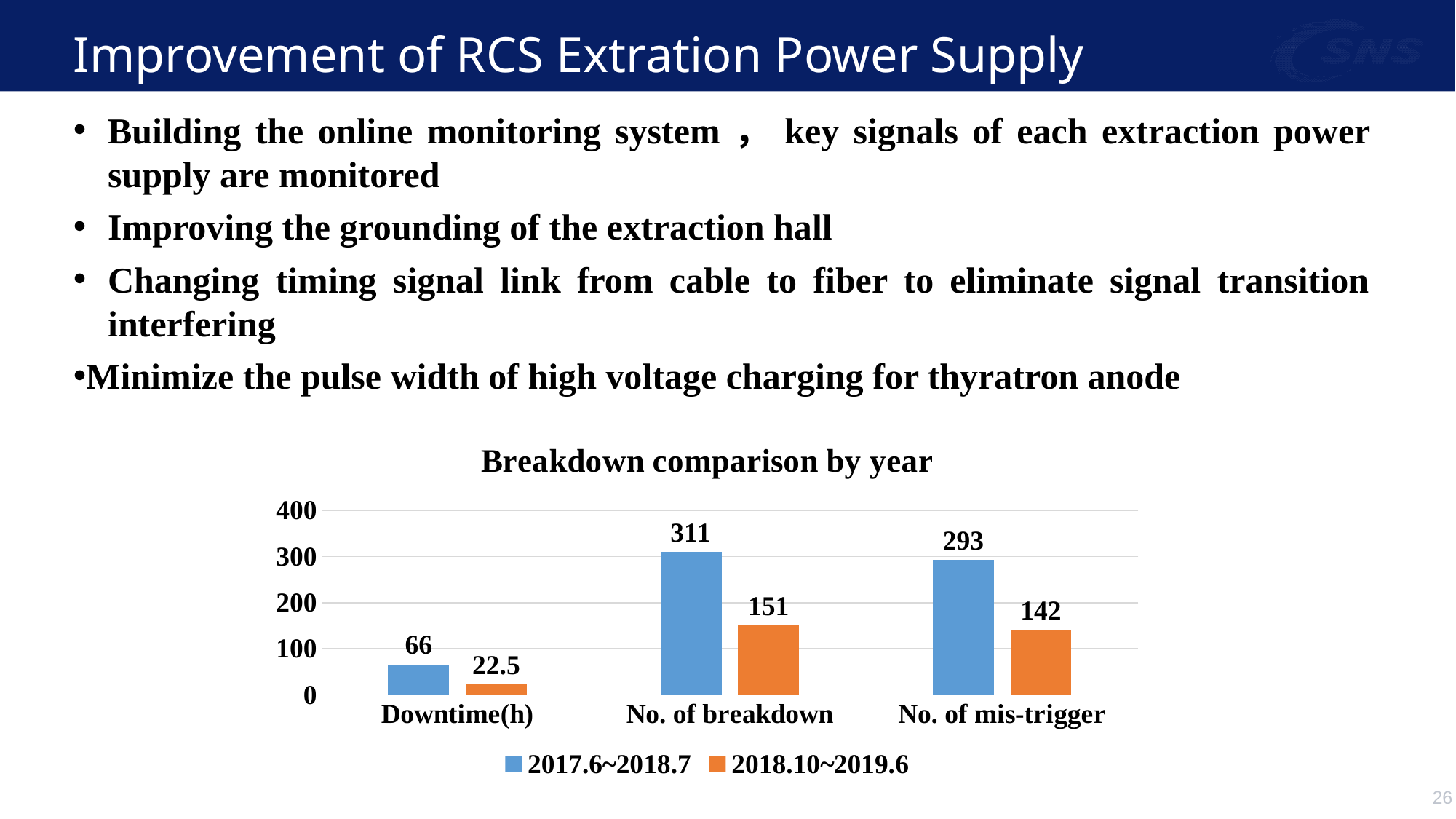
How many series does the legend list? 2 What is the title of the chart? Breakdown comparison by year Which is larger for No. of mis-trigger: the 2017.6~2018.7 value or the 2018.10~2019.6 value? 2017.6~2018.7 Which category has the lowest value in the 2018.10~2019.6 series? Downtime(h) How many categories are shown on the x axis? 3 What is the difference between the 2017.6~2018.7 and 2018.10~2019.6 values for No. of breakdown? 160 What is the value for Downtime(h) in the 2017.6~2018.7 series? 66 Is the 2017.6~2018.7 value for No. of mis-trigger greater or less than 200? greater What is the value for No. of mis-trigger in the 2017.6~2018.7 series? 293 What is the value for No. of breakdown in the 2018.10~2019.6 series? 151 Which category has the highest value in the 2017.6~2018.7 series? No. of breakdown What is the value for Downtime(h) in the 2018.10~2019.6 series? 22.5